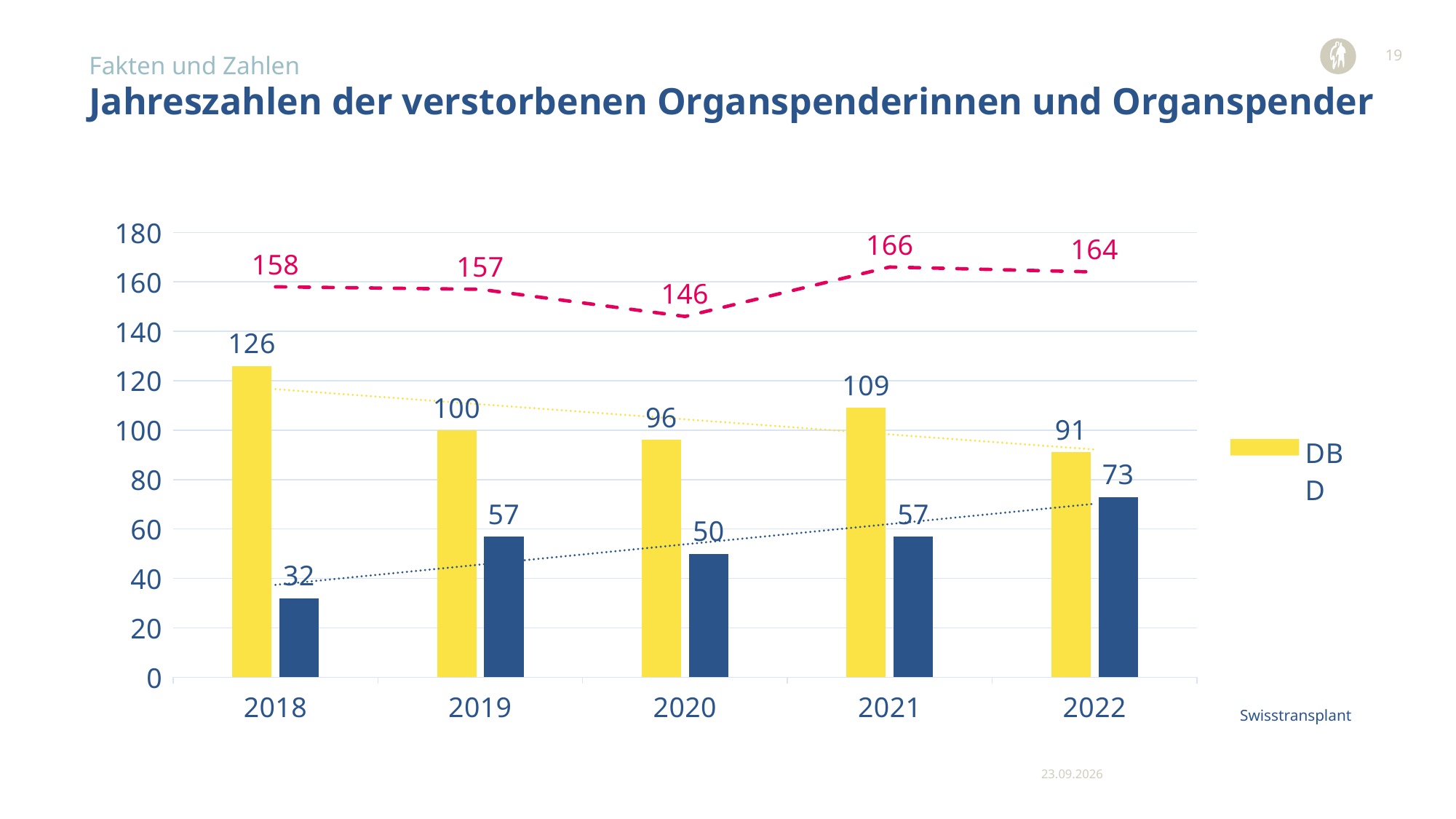
In which year does the red dashed line reach its highest value? 2021 How many years are shown on the x axis? 5 Which year has the larger yellow bar, 2019 or 2021? 2021 What is the value of the blue bar for 2022? 73 In which year is the yellow bar the highest? 2018 What kind of chart is shown on the slide? bar chart with a line Do the blue bars generally rise or fall from 2018 to 2022? rise Is the value of the blue bar for 2020 greater or less than 60? less In which year is the blue bar the lowest? 2018 What is the value of the yellow bar for 2018? 126 What value does the red dashed line show for 2020? 146 What is the difference between the yellow bar and the blue bar in 2021? 52